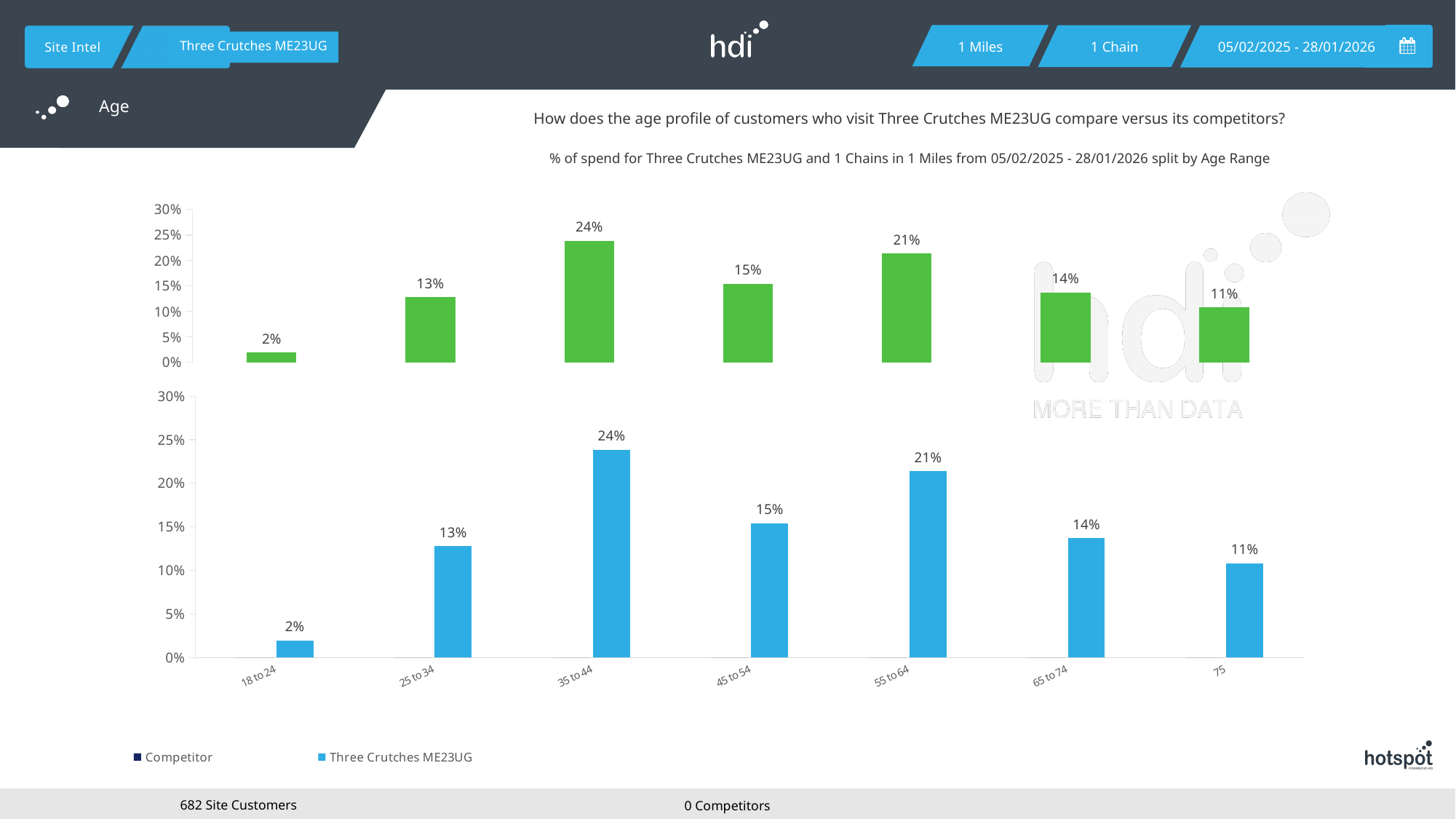
How many series does the legend at the bottom of the slide list? 2 In the bottom (blue) chart, what is the value for the 35 to 44 age range? 24% In the bottom (blue) chart, which age range has the highest value? 35 to 44 In the bottom (blue) chart, what is the value for the 18 to 24 age range? 2% How many age range categories are shown on the x axis of the bottom (blue) chart? 7 What type of chart is the bottom chart on the slide? Bar chart In the bottom (blue) chart, what is the difference between the values for 55 to 64 and 45 to 54? 6% In the bottom (blue) chart, what is the value for the 65 to 74 age range? 14% In the bottom (blue) chart, which is larger: the value for 25 to 34 or the value for 75? 25 to 34 In the bottom (blue) chart, which age range has the lowest value? 18 to 24 How many bars are plotted in the top (green) chart? 7 What is the highest data label shown in the top (green) chart? 24%